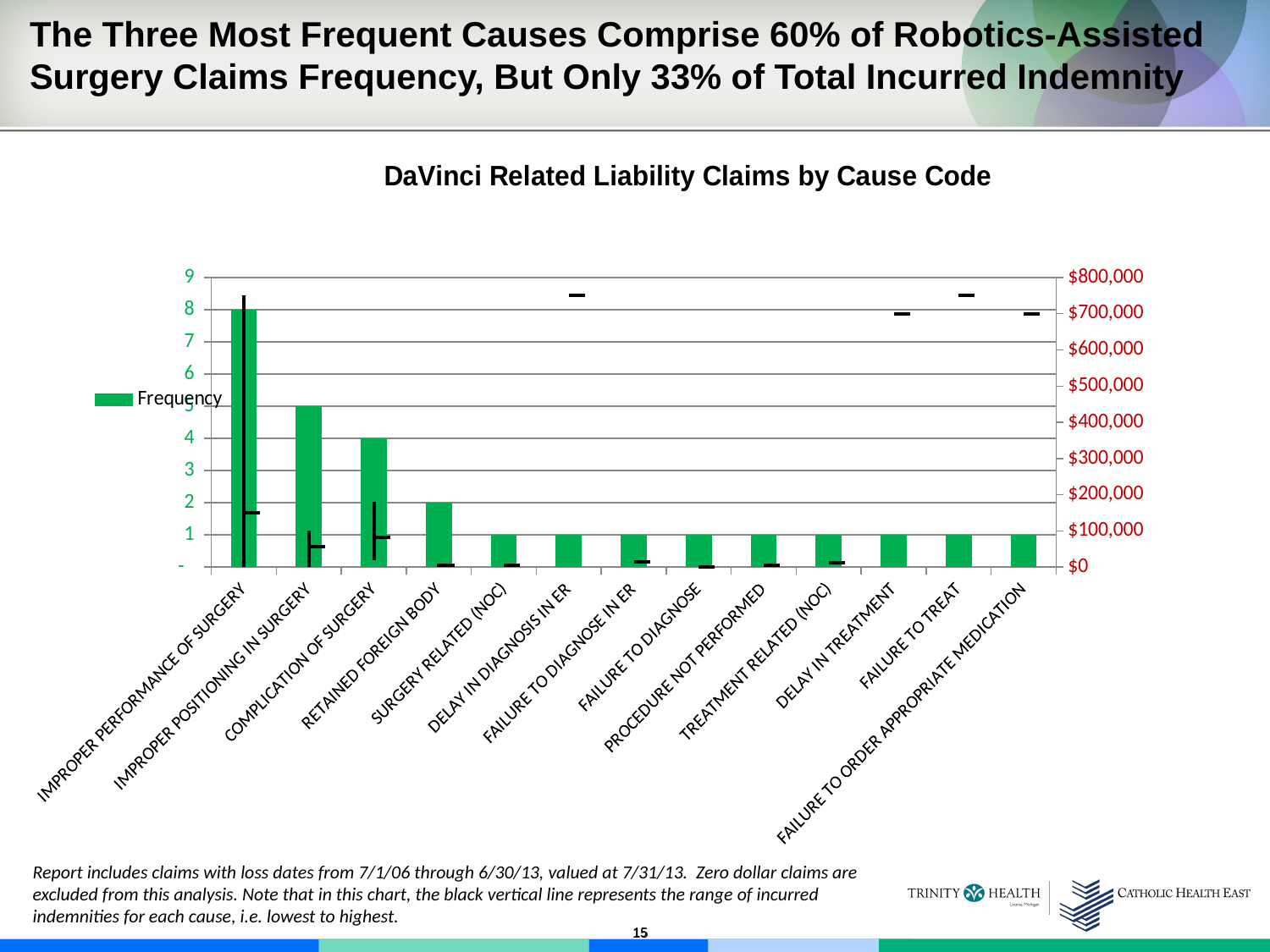
What is the frequency for RETAINED FOREIGN BODY? 2 What is the title of the chart? DaVinci Related Liability Claims by Cause Code Which has a higher frequency, COMPLICATION OF SURGERY or RETAINED FOREIGN BODY? COMPLICATION OF SURGERY How many cause codes are shown on the x axis? 13 Which cause code has the highest frequency? IMPROPER PERFORMANCE OF SURGERY What is the difference in frequency between IMPROPER PERFORMANCE OF SURGERY and IMPROPER POSITIONING IN SURGERY? 3 Do the frequency values rise or fall from left to right along the x axis? Fall How many series does the legend list? 1 What is the frequency for COMPLICATION OF SURGERY? 4 What is the frequency for IMPROPER POSITIONING IN SURGERY? 5 What kind of chart is this? Bar chart What is the frequency for IMPROPER PERFORMANCE OF SURGERY? 8